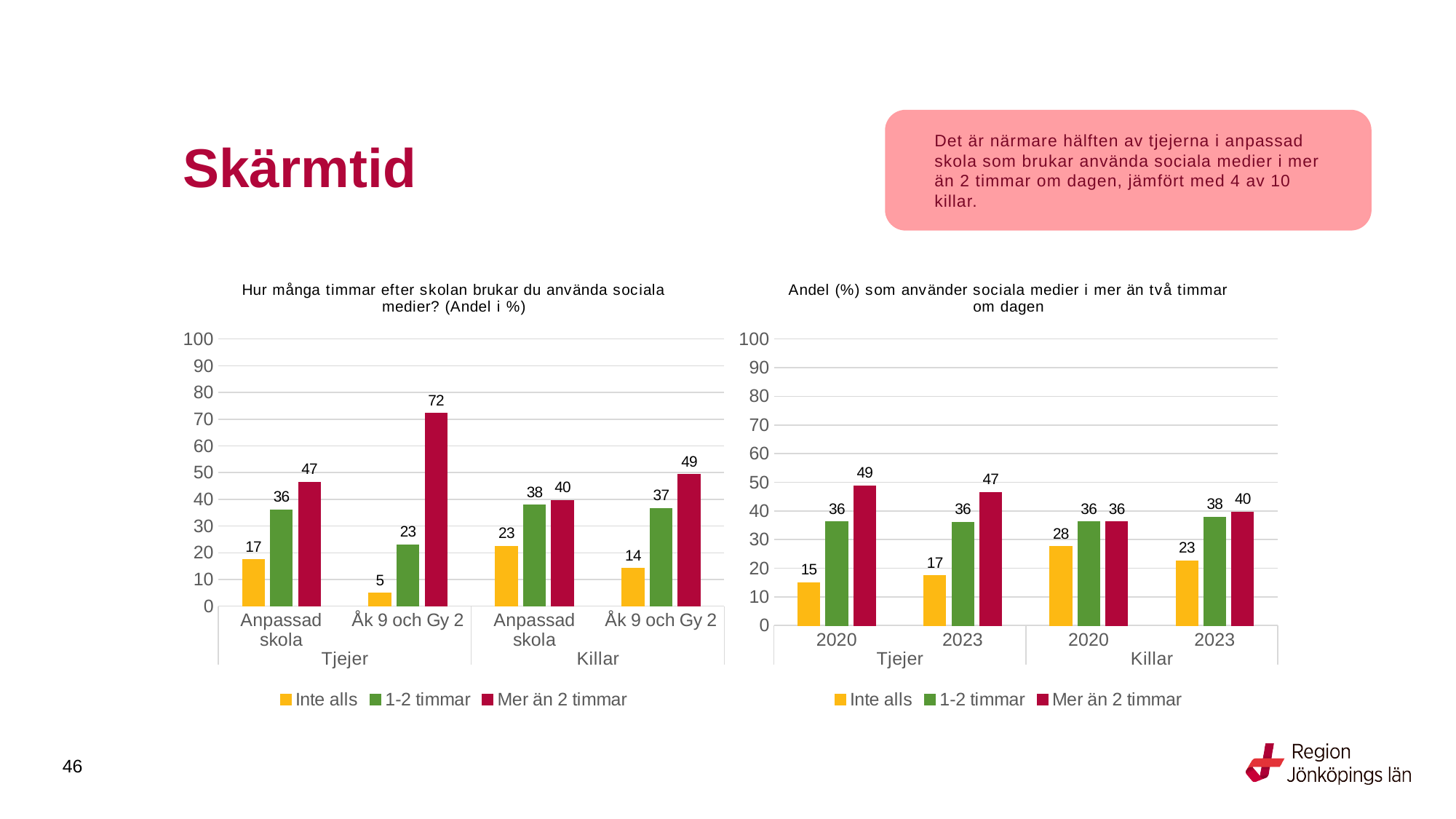
In the right chart, what is the difference between the "Mer än 2 timmar" values for Killar in 2023 and Killar in 2020? 4 In the left chart ("Hur många timmar efter skolan brukar du använda sociala medier?"), what is the value for "Mer än 2 timmar" for Tjejer in Åk 9 och Gy 2? 72 In the left chart, what is the difference between the "Mer än 2 timmar" values for Tjejer in Åk 9 och Gy 2 and Tjejer in Anpassad skola? 25 In the right chart, what is the "Inte alls" value for Killar in 2020? 28 In the left chart, how many series does the legend list? 3 In the right chart, how many year-and-gender groups are shown on the x axis? 4 What kind of chart is the left chart? Bar chart In the left chart, what is the value for "Inte alls" for Killar in Anpassad skola? 23 In the right chart, which is larger for Killar in 2023: "1-2 timmar" or "Mer än 2 timmar"? Mer än 2 timmar In the right chart ("Andel (%) som använder sociala medier i mer än två timmar om dagen"), what is the "Mer än 2 timmar" value for Tjejer in 2020? 49 In the left chart, which group has the highest "Mer än 2 timmar" value? Tjejer, Åk 9 och Gy 2 In the left chart, which group has the lowest "Inte alls" value? Tjejer, Åk 9 och Gy 2